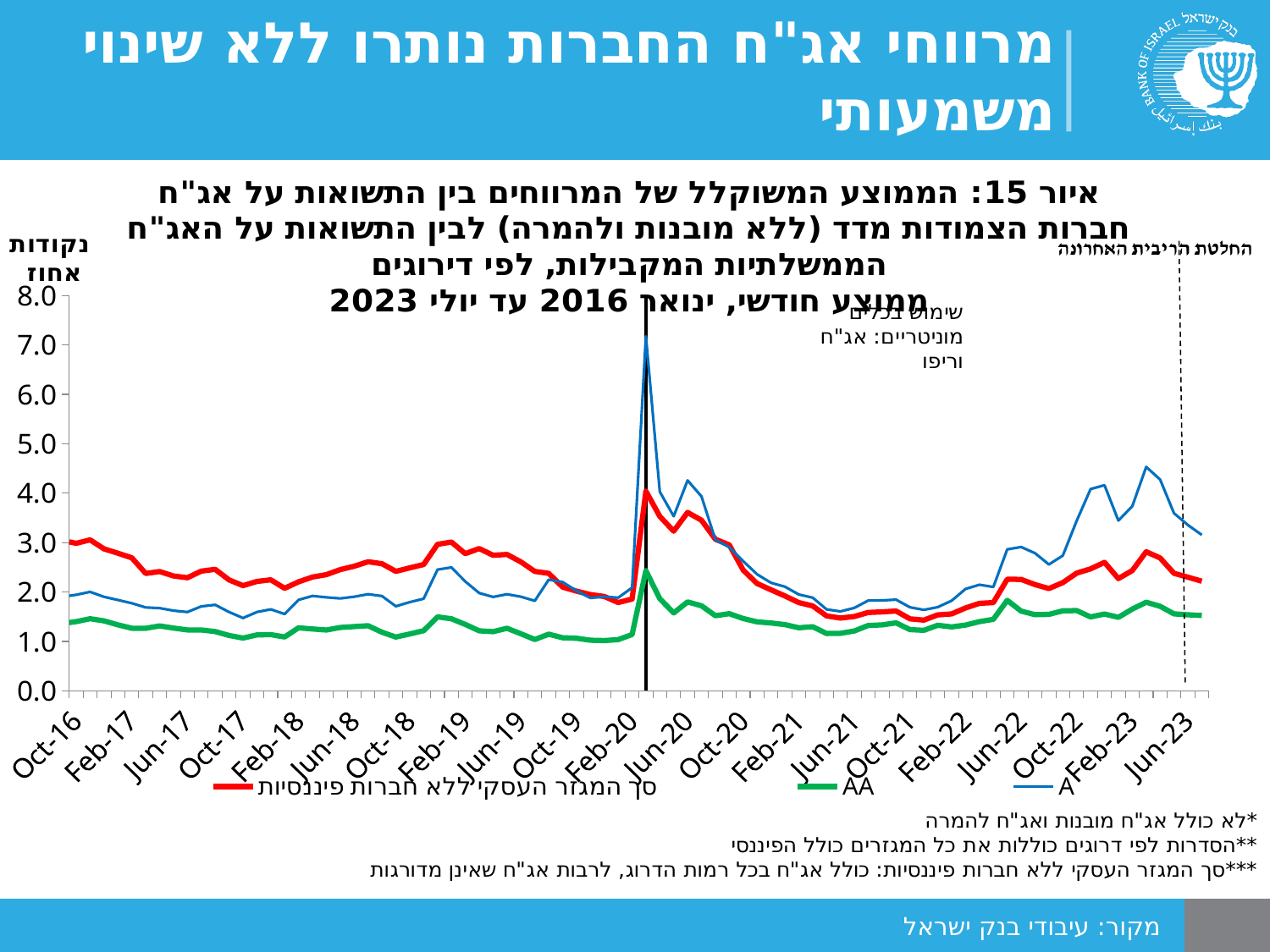
What kind of chart is shown on the slide? line chart Is the value of the red series (סך המגזר העסקי ללא חברות פיננסיות) at Oct-16 greater or less than 2.0? greater At Jun-23, which series has the larger value, A or AA? A Do the values of the A series rise or fall between its 2020 peak and Feb-21? fall What is the highest tick shown on the y axis? 8.0 Is the peak value of the A series in 2020 greater or less than 6.0? greater How many series does the legend list? 3 Which series reaches the highest value on the chart? A What is the unit label shown on the y axis? נקודות אחוז What is the first date label on the x axis? Oct-16 Which series is the lowest across the chart? AA Is the value of the AA series at Oct-16 greater or less than 2.0? less